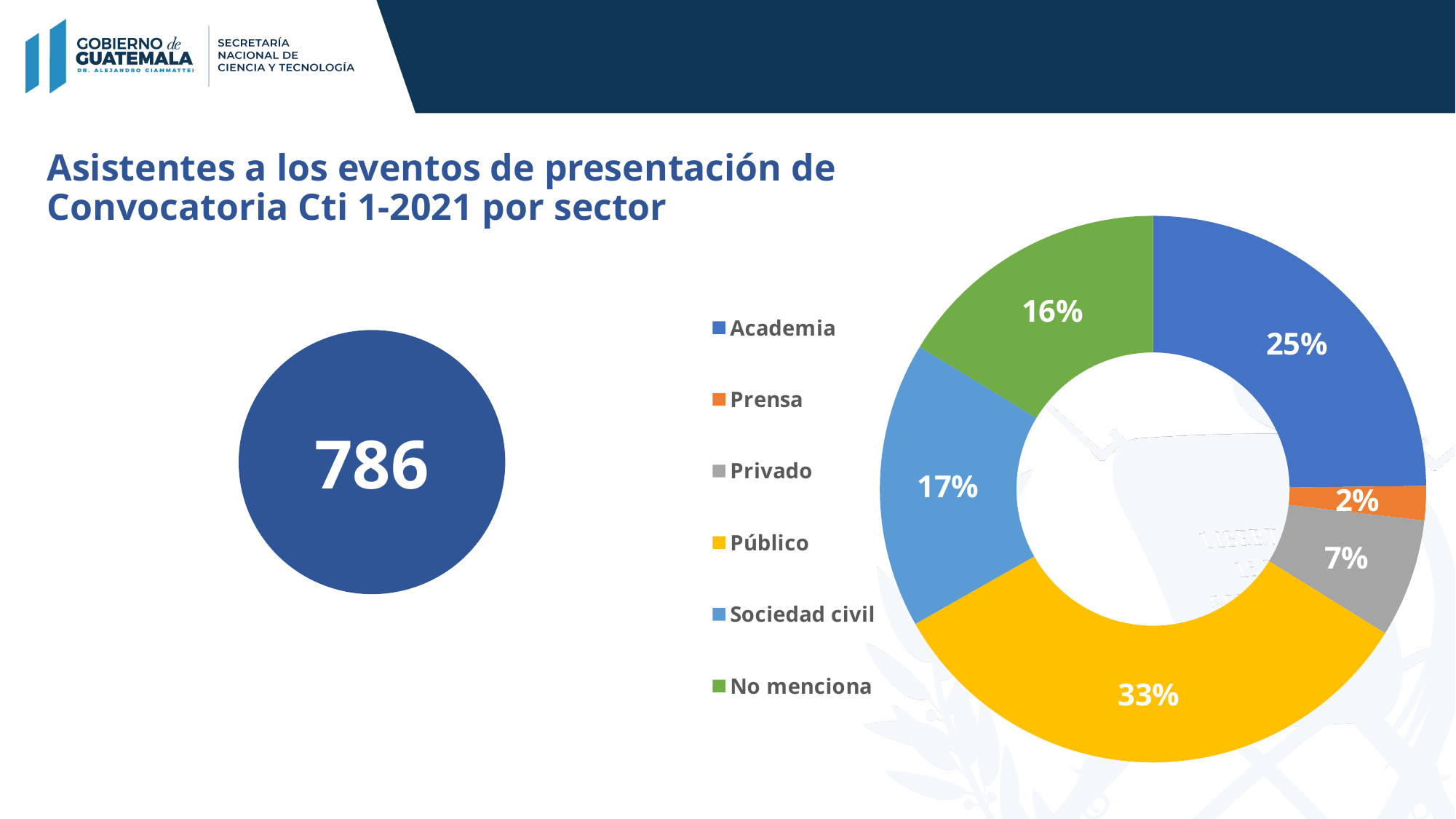
What total number of attendees is shown in the circle on the left? 786 What percentage is shown for the Público sector? 33% Which sector has the largest share of attendees? Público What kind of chart is used to show attendees by sector? Doughnut chart What percentage is shown for the Prensa sector? 2% Which has a larger share, Sociedad civil or No menciona? Sociedad civil What colour represents the Privado sector in the chart? Grey What share of attendees does the Academia sector represent? 25% What is the difference in percentage points between Público and Academia? 8 How many sectors are listed in the legend? 6 Which sector has the smallest share of attendees? Prensa What percentage is shown for Sociedad civil? 17%